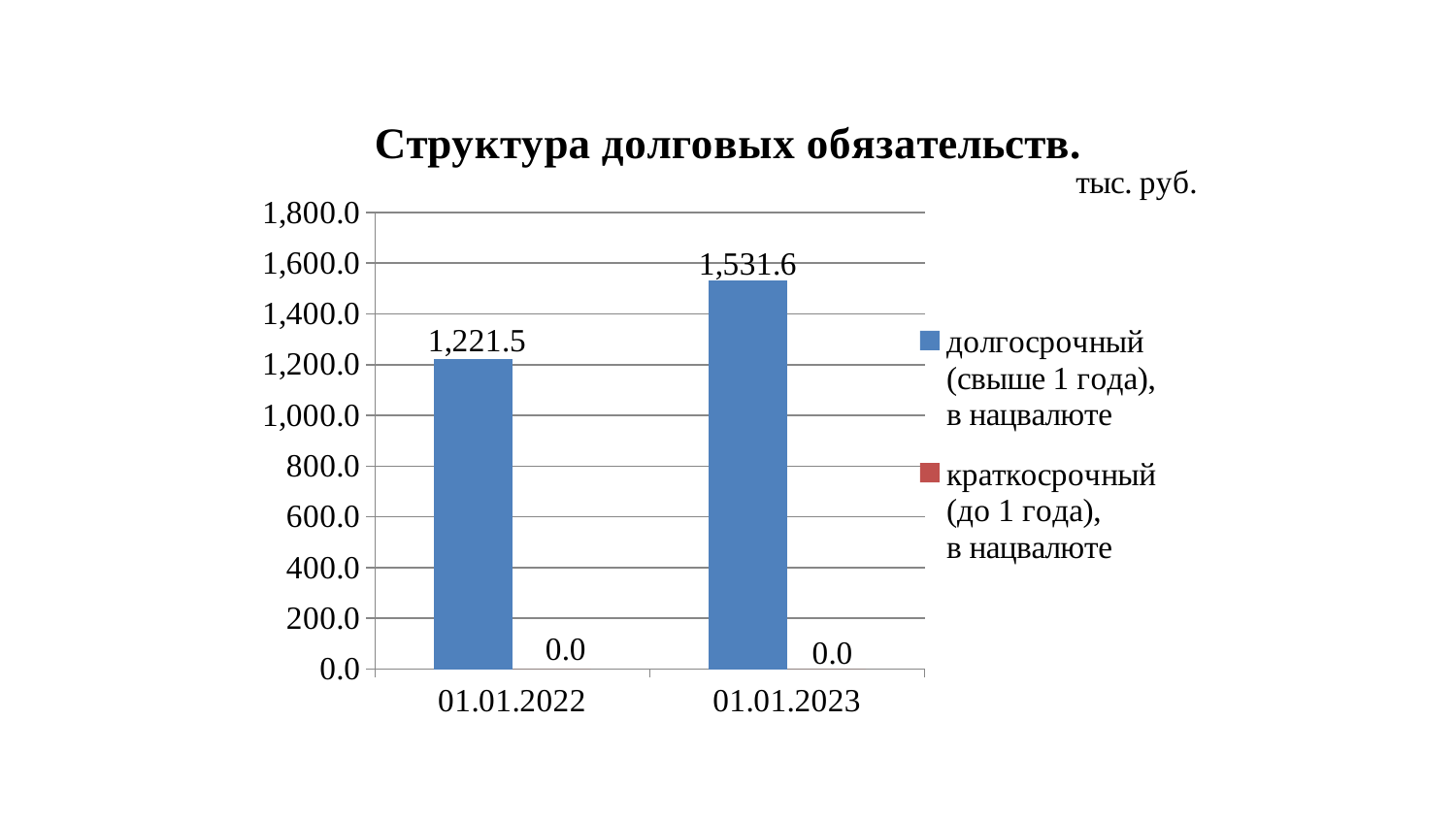
What is the title of the chart? Структура долговых обязательств. How many dates are shown on the x axis? 2 What is the value of долгосрочный (свыше 1 года), в нацвалюте for 01.01.2022? 1,221.5 What is the value of краткосрочный (до 1 года), в нацвалюте for 01.01.2022? 0.0 What is the difference between the долгосрочный values for 01.01.2023 and 01.01.2022? 310.1 What kind of chart is shown on the slide? bar chart Which date has the higher value for долгосрочный (свыше 1 года), в нацвалюте? 01.01.2023 What is the value of долгосрочный (свыше 1 года), в нацвалюте for 01.01.2023? 1,531.6 Is the долгосрочный value for 01.01.2023 greater or less than 1,400.0? greater How many series does the legend list? 2 What is the value of краткосрочный (до 1 года), в нацвалюте for 01.01.2023? 0.0 Is the долгосрочный value for 01.01.2022 larger or smaller than the value for 01.01.2023? smaller